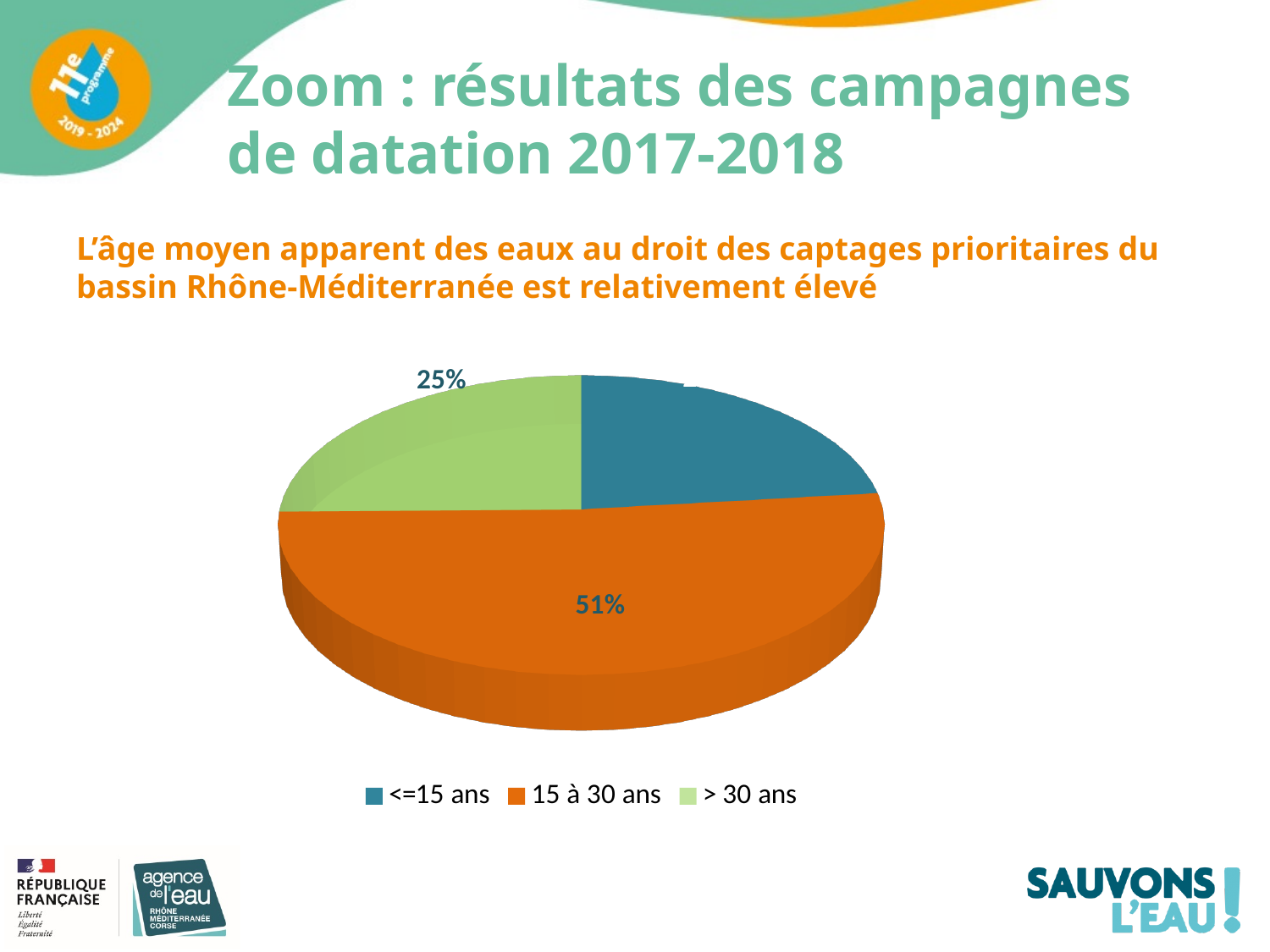
How many categories does the pie chart show? 3 Which category has the largest slice of the pie? 15 à 30 ans Which colour represents the "<=15 ans" category in the pie chart? blue What share of the pie does the "> 30 ans" slice represent? 25% Is the share for "15 à 30 ans" greater or less than 50%? greater What is the difference in percentage points between the "15 à 30 ans" slice and the "> 30 ans" slice? 26 What kind of chart is shown on the slide? pie chart What share of the pie does the "15 à 30 ans" slice represent? 51% How many entries does the legend list? 3 Which is larger, the slice for "15 à 30 ans" or the slice for "> 30 ans"? 15 à 30 ans What is the title of the slide containing the pie chart? Zoom : résultats des campagnes de datation 2017-2018